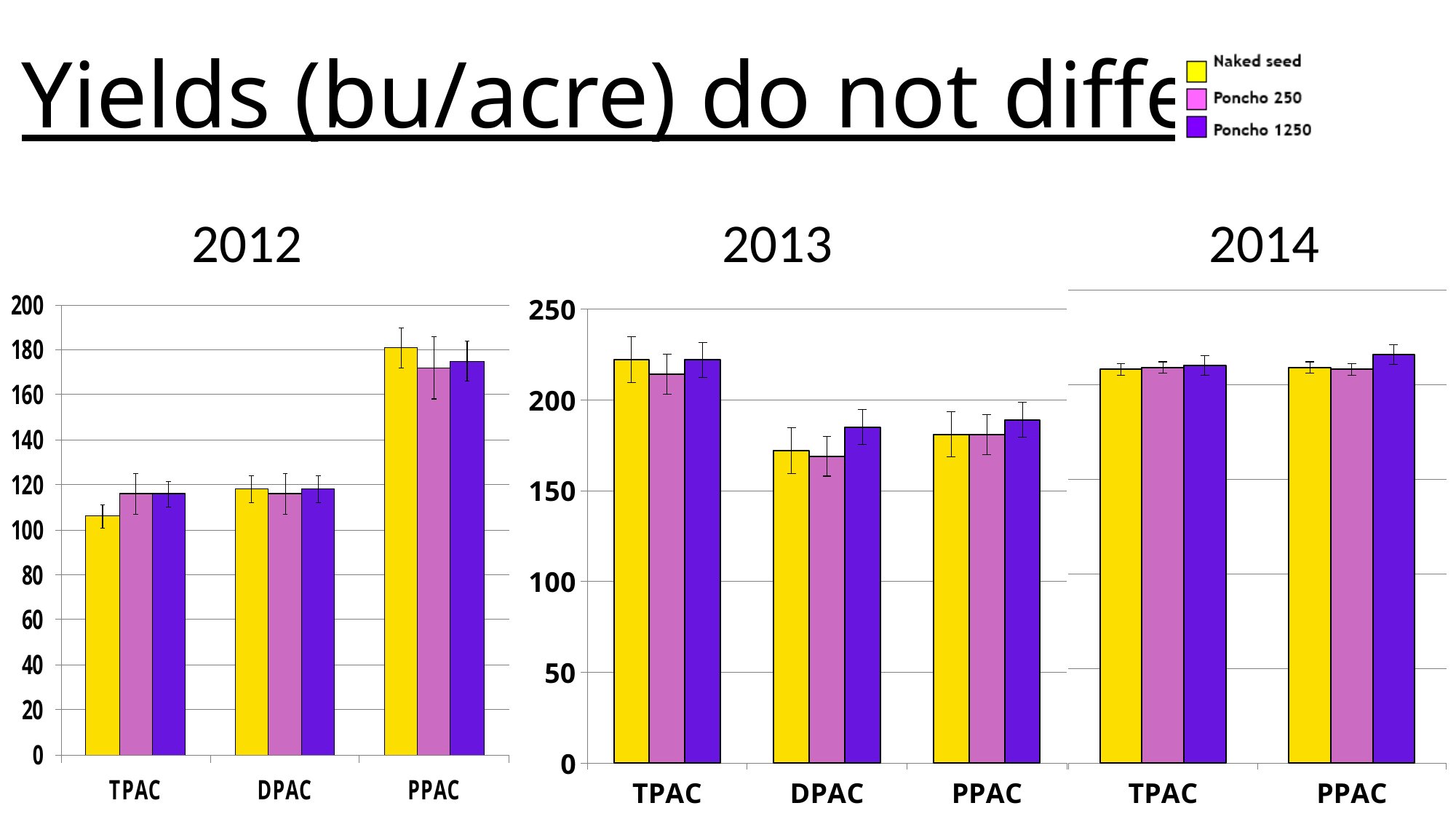
How many series does the legend list? 3 In the 2012 chart, is the Naked seed value for TPAC greater or less than 120? less In the 2013 chart, is the Poncho 250 value for DPAC greater or less than 200? less What kind of chart is the 2012 chart? bar chart In the 2013 chart, is the Naked seed value for TPAC greater or less than 200? greater Which legend entry is shown in yellow? Naked seed In the 2012 chart, which category has the highest bars? PPAC How many categories are shown on the x axis of the 2014 chart? 2 In the 2013 chart, which category has the highest bars? TPAC In the 2013 chart, which is larger, the Naked seed value for TPAC or the Naked seed value for DPAC? TPAC How many categories are shown on the x axis of the 2013 chart? 3